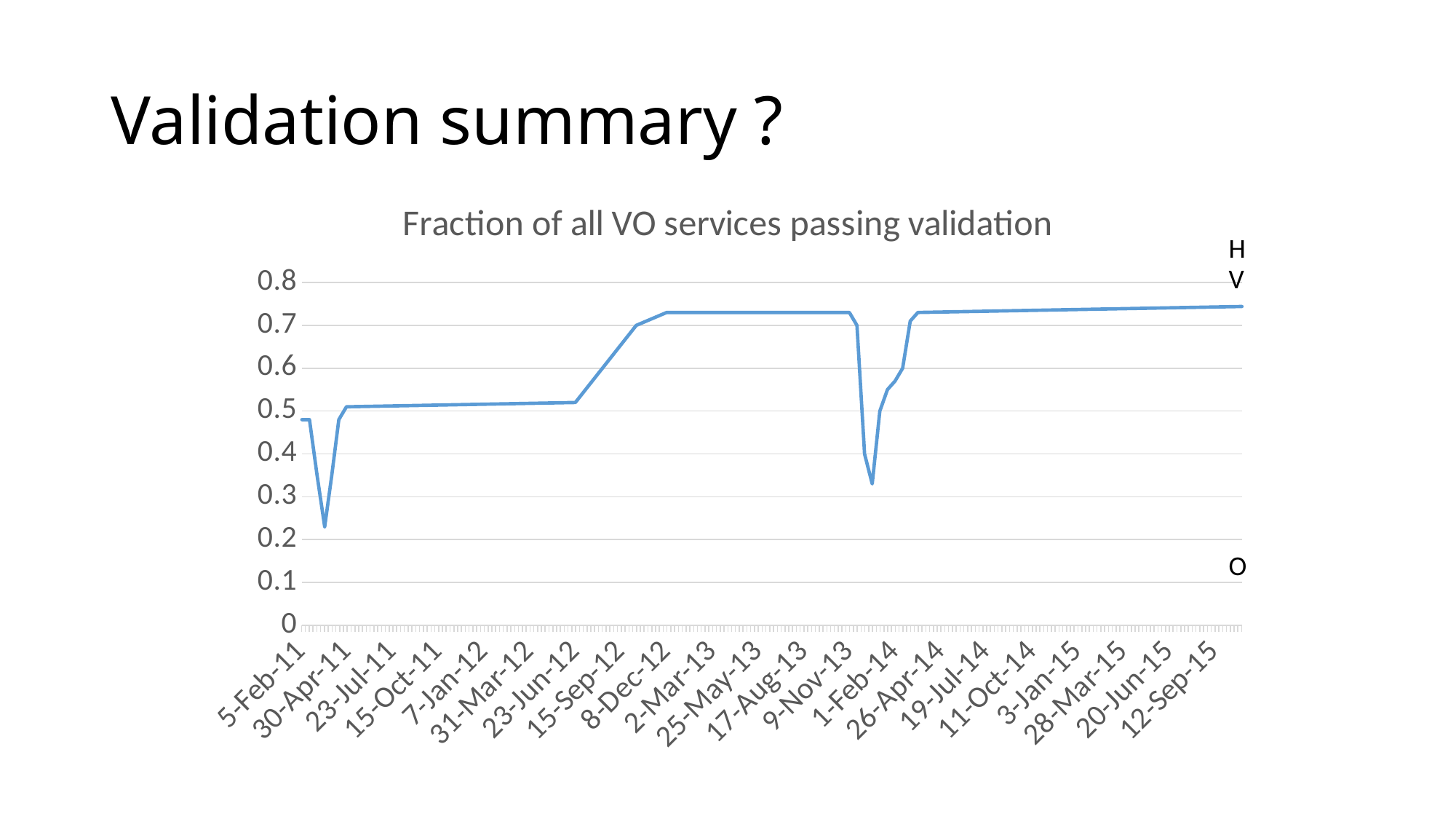
What kind of chart is shown on the slide? line chart Overall, does the fraction rise or fall from 5-Feb-11 to 12-Sep-15? rise What is the highest value shown on the y axis? 0.8 Is the value at 12-Sep-15 greater or less than 0.7? greater Is the lowest point of the dip in early 2014 greater or less than 0.4? less Is the lowest point of the dip in early 2011 greater or less than 0.3? less Which is larger, the value at 5-Feb-11 or the value at 12-Sep-15? 12-Sep-15 Which dip reaches a lower value, the one in early 2011 or the one in early 2014? early 2011 What is the title of the chart? Fraction of all VO services passing validation